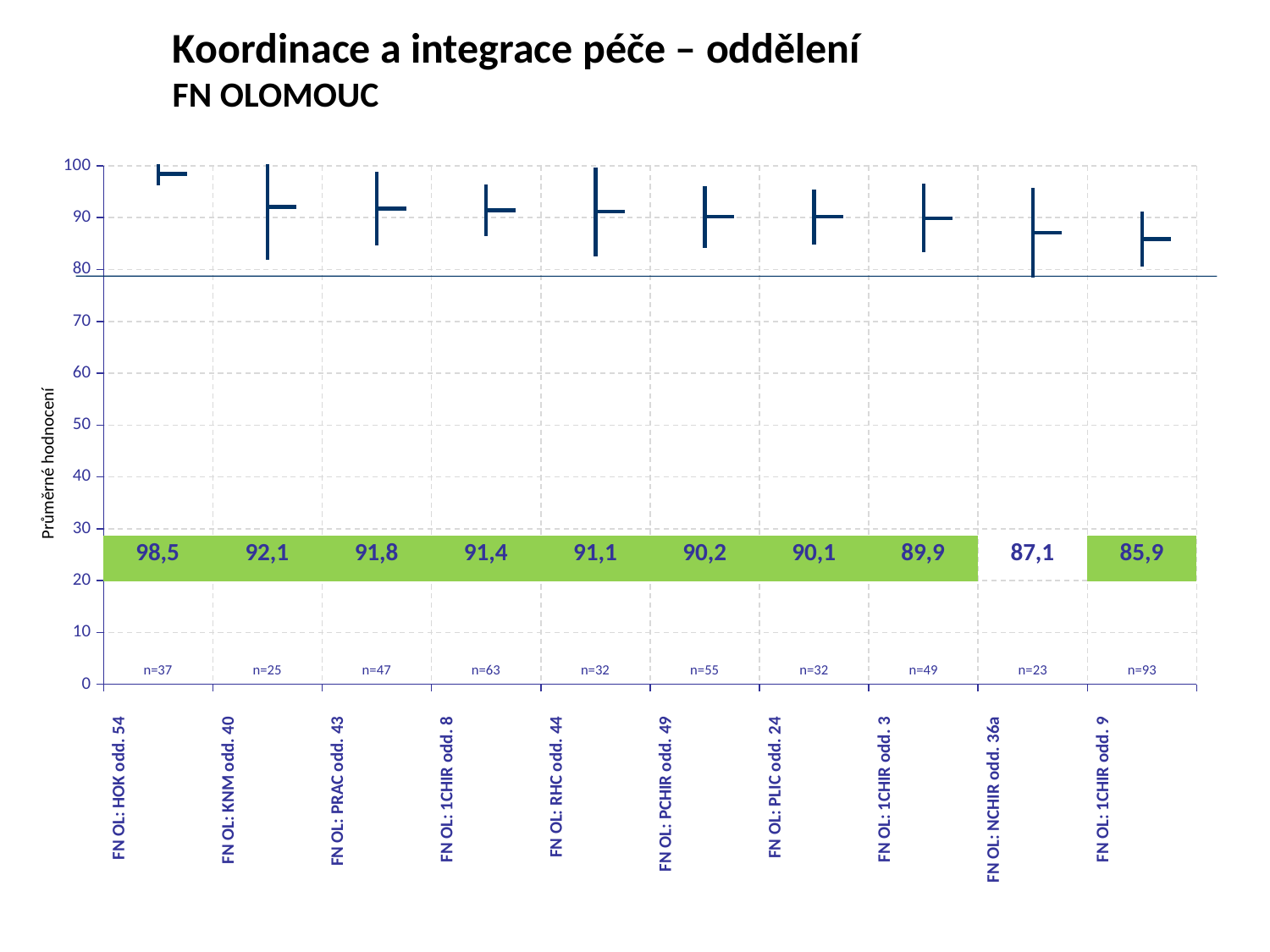
What is the average rating for FN OL: HOK odd. 54? 98,5 Which department has the lowest average rating? FN OL: 1CHIR odd. 9 What is the label of the vertical axis? Průměrné hodnocení Do the average ratings rise or fall from left to right along the x axis? fall Which department has the highest average rating? FN OL: HOK odd. 54 What is the average rating for FN OL: PCHIR odd. 49? 90,2 How many departments are shown on the chart? 10 What is the average rating for FN OL: NCHIR odd. 36a? 87,1 What is the difference between the average ratings of FN OL: HOK odd. 54 and FN OL: 1CHIR odd. 9? 12,6 Which has a higher average rating, FN OL: KNM odd. 40 or FN OL: PLIC odd. 24? FN OL: KNM odd. 40 Which department's value label is shown on a white background instead of green? FN OL: NCHIR odd. 36a What is the number of respondents (n) shown for FN OL: 1CHIR odd. 9? n=93